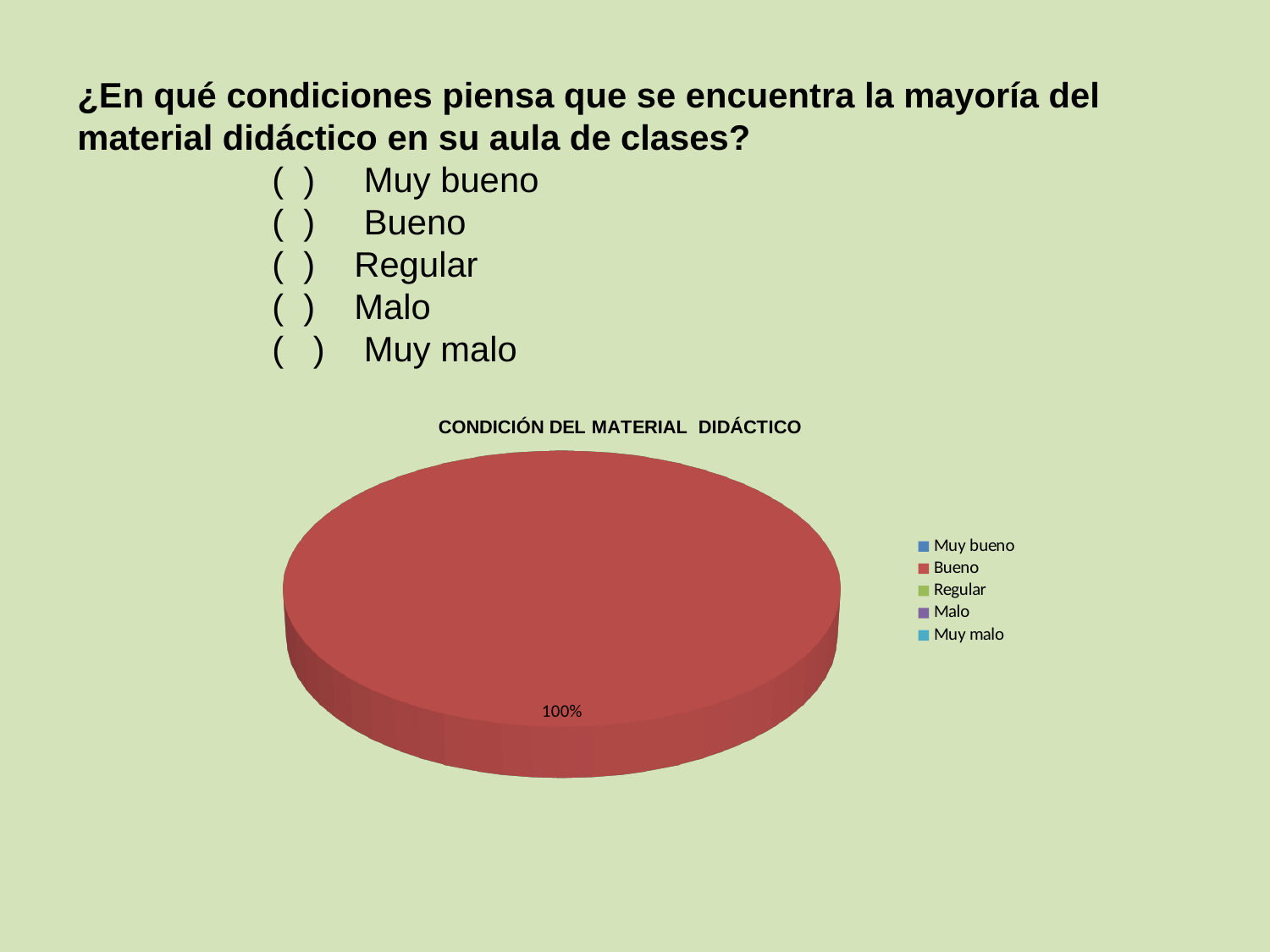
What kind of chart is shown on the slide? pie chart Which legend entry corresponds to the red slice that fills the whole pie? Bueno What share of the pie does the Bueno slice take? 100% What is the title of the chart? CONDICIÓN DEL MATERIAL DIDÁCTICO Is the share for Bueno greater or less than 50%? greater Which category has the largest share of the pie? Bueno How many entries does the chart legend list? 5 What percentage is printed as the data label on the pie? 100%